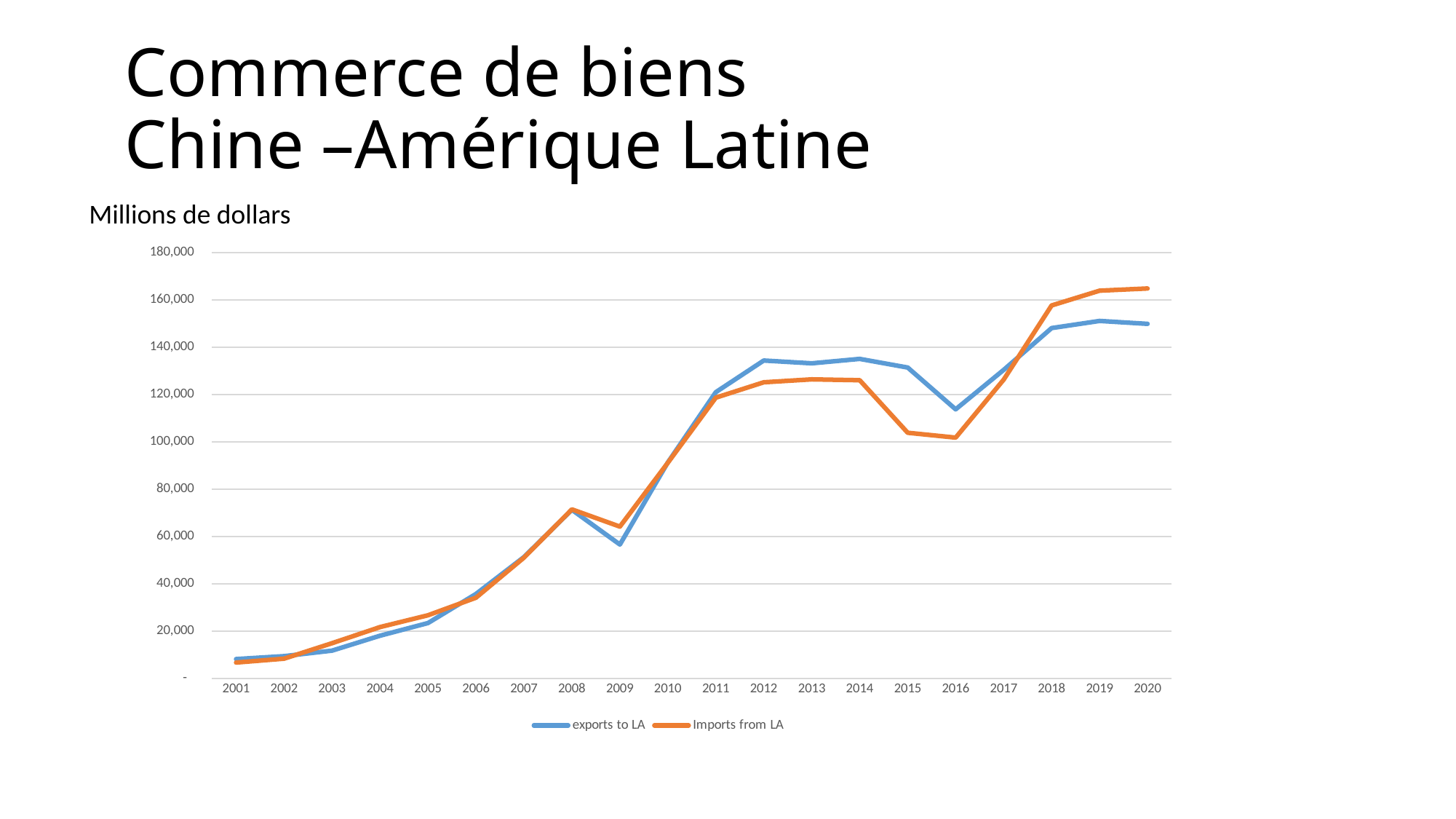
How many years are plotted along the x axis? 20 How many series does the legend list? 2 In 2016, which series has the larger value, exports to LA or Imports from LA? exports to LA What unit is stated above the chart? Millions de dollars Is the value for exports to LA in 2009 greater or less than 60,000? less Is the value for Imports from LA in 2020 greater or less than 160,000? greater Overall, do the values for Imports from LA rise or fall from 2001 to 2020? rise What kind of chart is shown on the slide? line chart Is the value for exports to LA in 2012 greater or less than 120,000? greater In 2020, which series has the larger value, exports to LA or Imports from LA? Imports from LA What are the two series named in the legend? exports to LA and Imports from LA